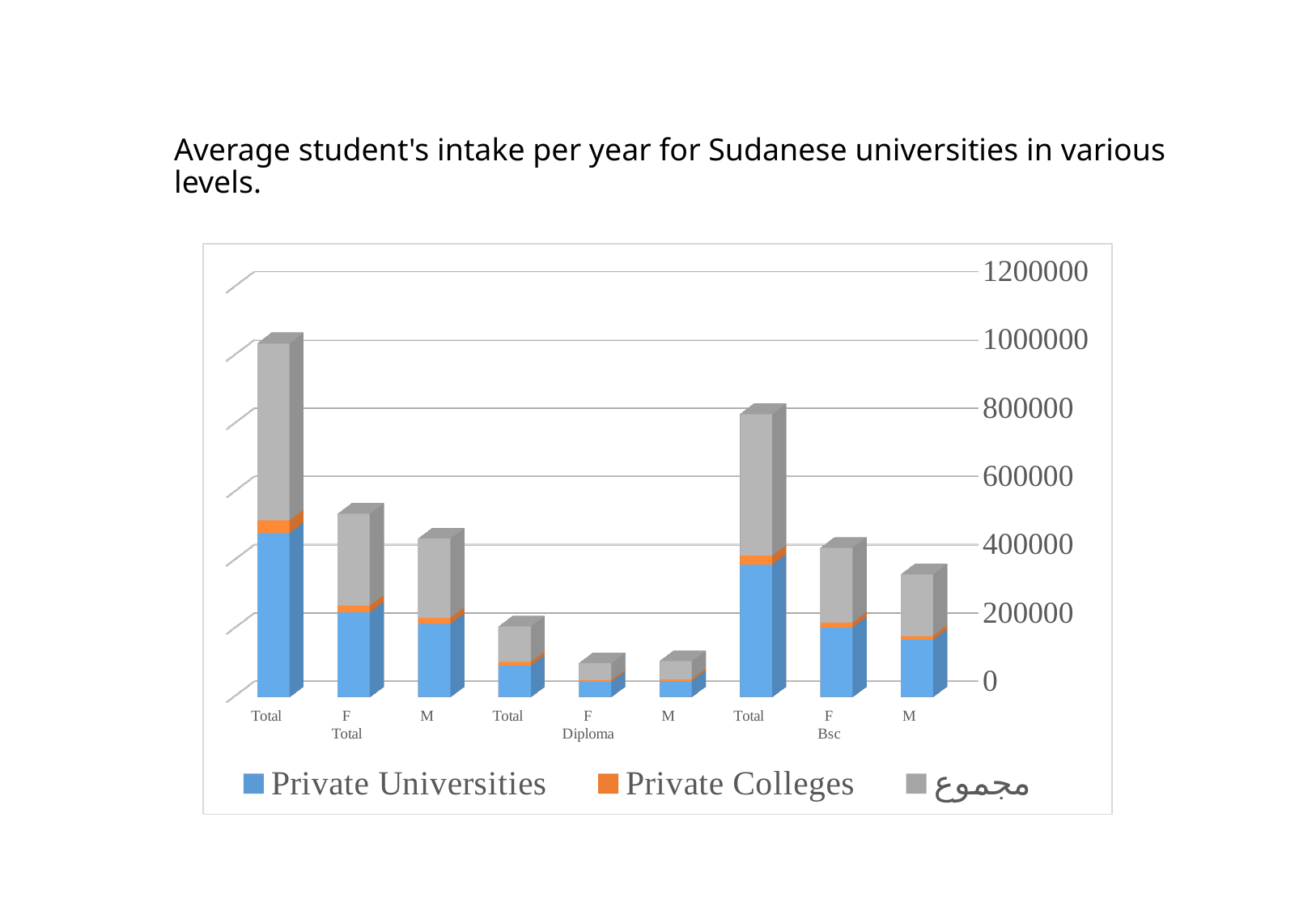
How many bars are plotted in the chart? 9 Is the total for the Total bar in the Total group greater or less than 800000? greater Which series is shown in orange in the legend? Private Colleges Is the total for the F bar in the Total group greater or less than 400000? greater How many series does the legend list? 3 Is the total for the Total bar in the Bsc group greater or less than 600000? greater Which is larger, the F bar in the Total group or the F bar in the Bsc group? F bar in the Total group Which is larger, the Total bar in the Bsc group or the Total bar in the Diploma group? Total bar in the Bsc group Which bar reaches the highest total in the chart? Total (Total group) What kind of chart is shown on the slide? bar chart